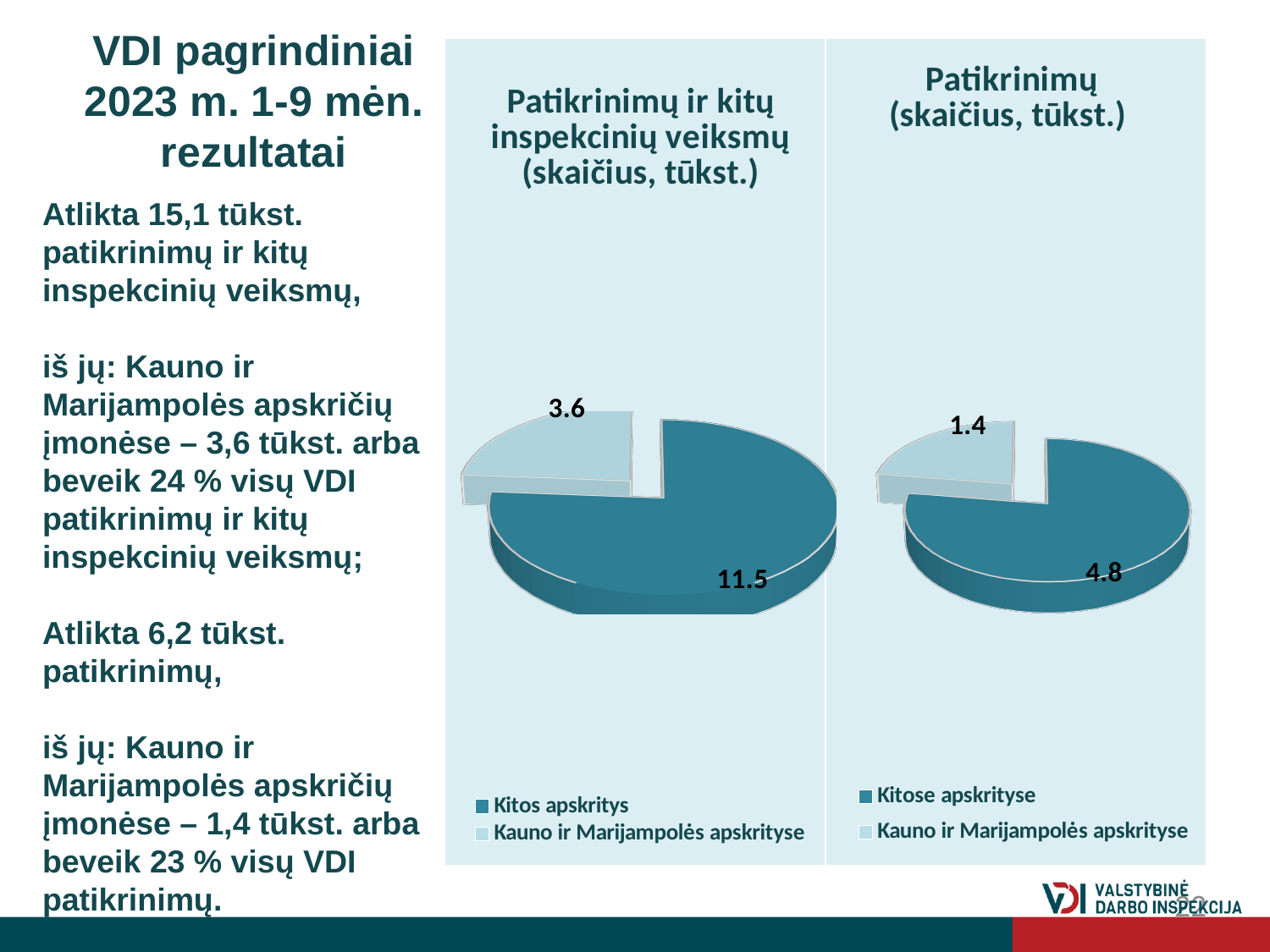
How many categories does the legend of the left chart (Patikrinimų ir kitų inspekcinių veiksmų) list? 2 In the right chart (Patikrinimų), what is the value for Kitose apskrityse? 4.8 What kind of chart is the right chart (Patikrinimų)? Pie chart In the left chart (Patikrinimų ir kitų inspekcinių veiksmų), what is the total of the two slices? 15.1 In the left chart (Patikrinimų ir kitų inspekcinių veiksmų), which category has the largest slice? Kitos apskritys In the right chart (Patikrinimų), which category has the smallest slice? Kauno ir Marijampolės apskrityse In the right chart (Patikrinimų), what is the value for Kauno ir Marijampolės apskrityse? 1.4 In the right chart (Patikrinimų), what is the total of the two slices? 6.2 In the right chart (Patikrinimų), what is the difference between Kitose apskrityse and Kauno ir Marijampolės apskrityse? 3.4 In the left chart (Patikrinimų ir kitų inspekcinių veiksmų), what is the value for Kitos apskritys? 11.5 In the left chart (Patikrinimų ir kitų inspekcinių veiksmų), what is the value for Kauno ir Marijampolės apskrityse? 3.6 In the left chart (Patikrinimų ir kitų inspekcinių veiksmų), what is the difference between Kitos apskritys and Kauno ir Marijampolės apskrityse? 7.9